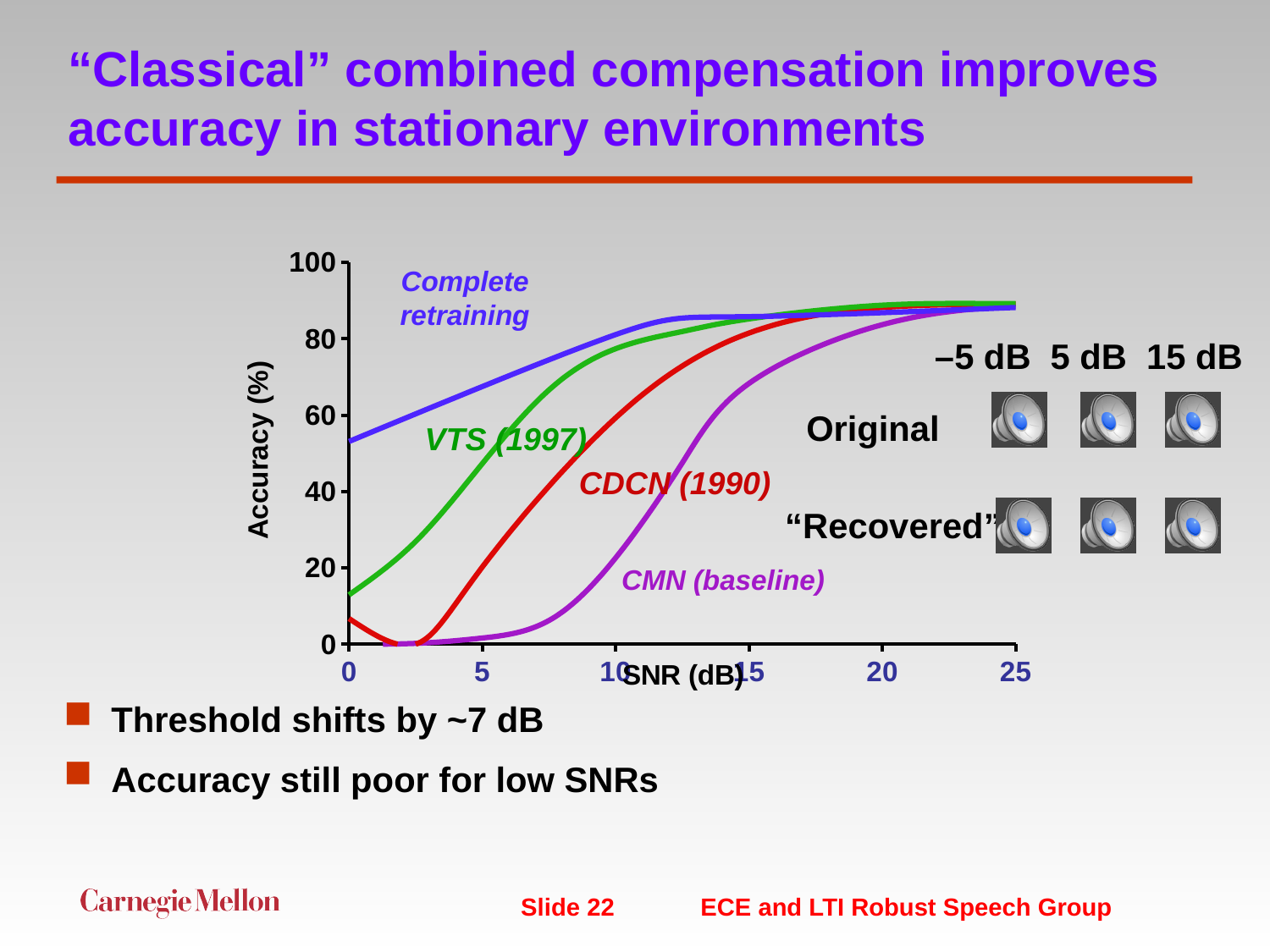
Does accuracy rise or fall as SNR increases along the x axis? rise At an SNR of 10 dB, which curve has higher accuracy, VTS (1997) or CMN (baseline)? VTS (1997) Is the accuracy of the VTS (1997) curve at 0 dB SNR greater or less than 20? less Is the accuracy of the Complete retraining curve at 0 dB SNR greater or less than 40? greater What is the label of the x axis of the chart? SNR (dB) How many curves (series) are plotted on the chart? 4 What is the label of the y axis of the chart? Accuracy (%) Which curve has the highest accuracy at an SNR of 0 dB? Complete retraining Which curve has the lowest accuracy at an SNR of 10 dB? CMN (baseline) Is the accuracy of the CDCN (1990) curve at 10 dB SNR greater or less than 40? greater What kind of chart is shown on the slide? line chart